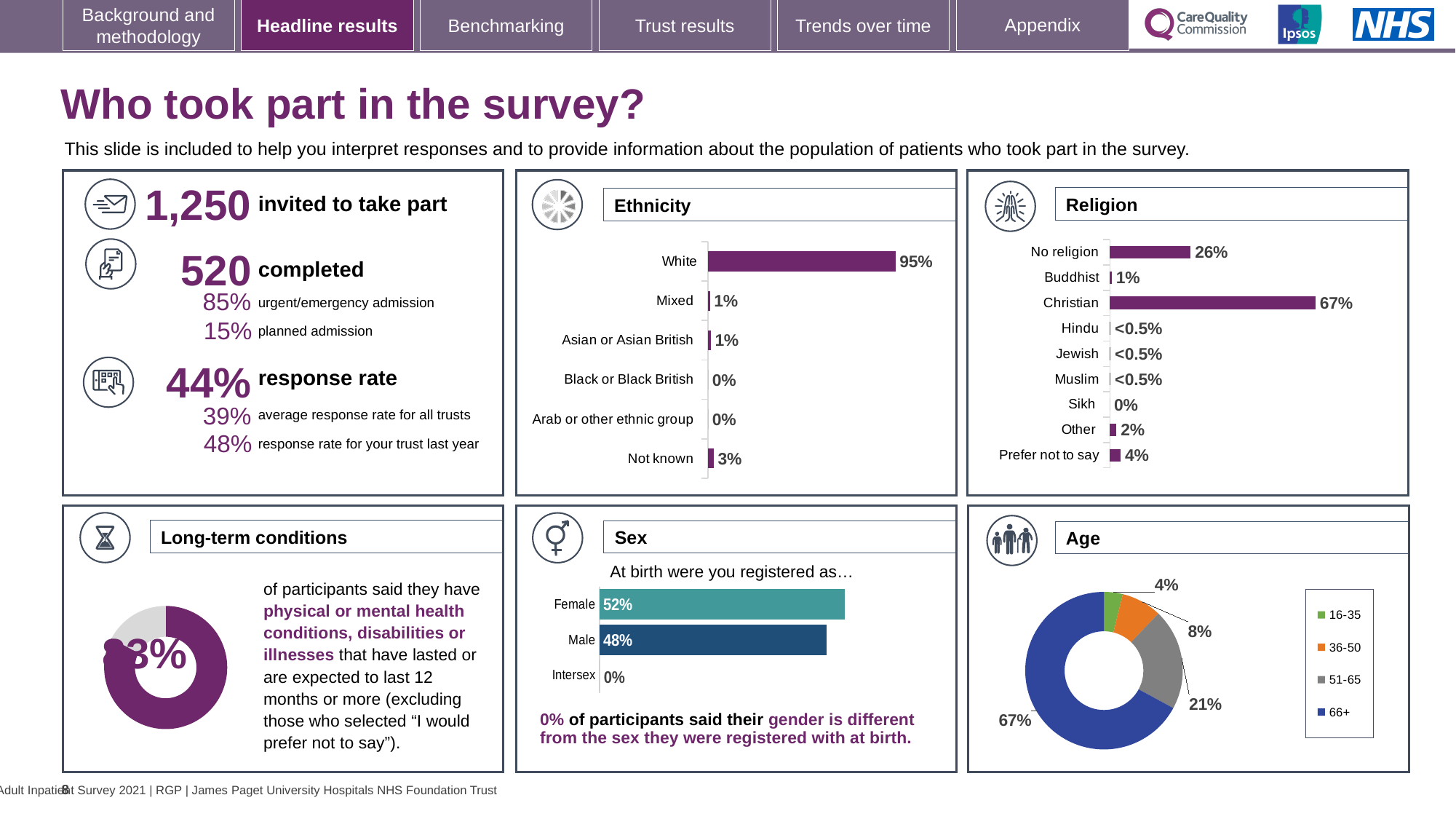
In the Religion chart, what percentage of participants were Christian? 67% In the Ethnicity chart, which category has the highest value? White In the Ethnicity chart, what percentage of participants were recorded as Not known? 3% How many categories are shown in the Ethnicity chart? 6 In the Religion chart, which is larger, Other or Prefer not to say? Prefer not to say In the Religion chart, what is the difference between the Christian and No religion values? 41% In the Sex chart, what is the difference between the Female and Male values? 4% What type of chart is the Age chart? Doughnut chart In the Sex chart, what percentage of participants were registered as Female at birth? 52% In the Religion chart, what percentage of participants had No religion? 26% In the Age chart, what share of participants were aged 66+? 67% In the Ethnicity chart, what percentage of participants were White? 95%